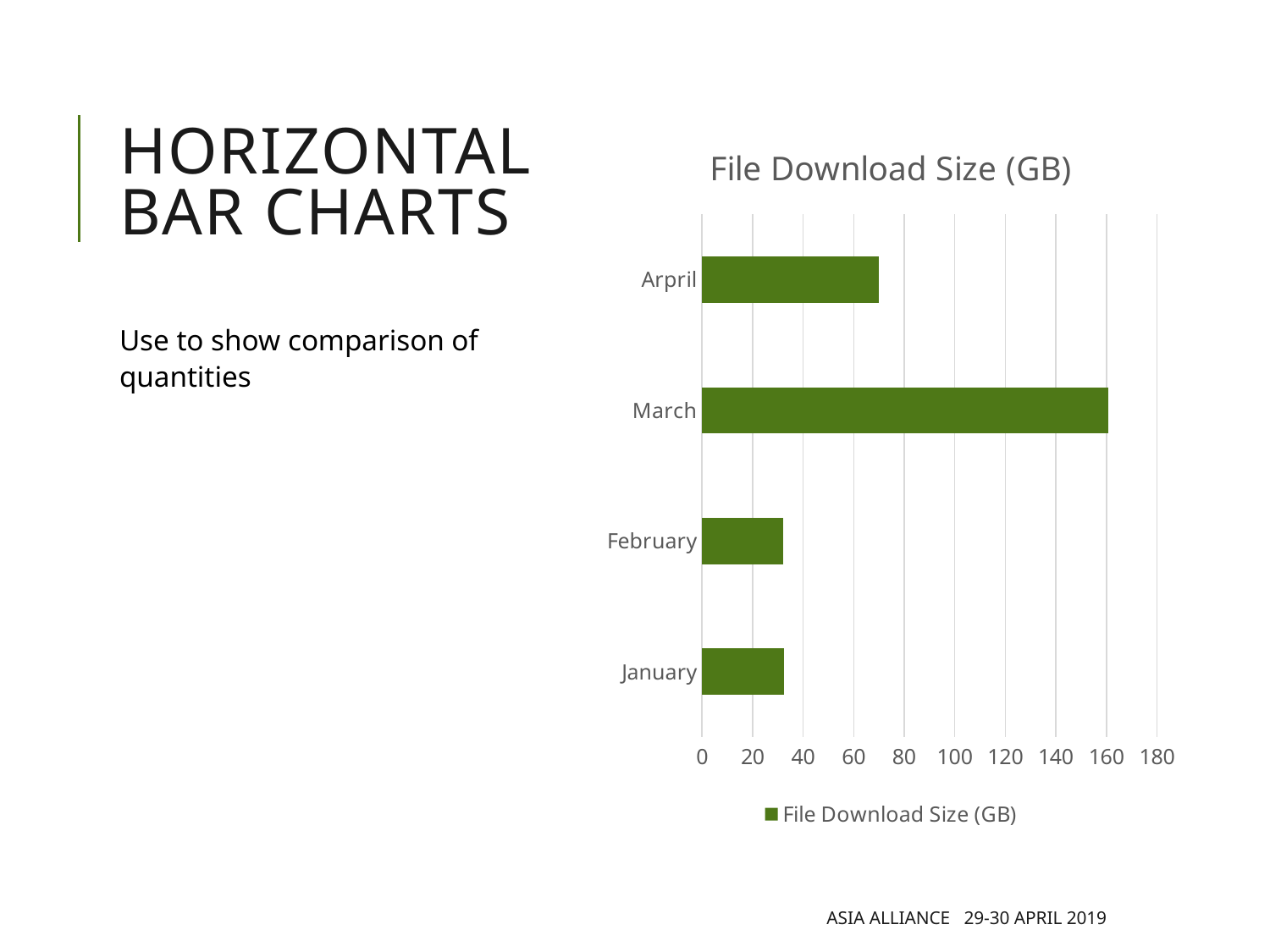
What type of chart is shown on the slide? bar chart Which is larger, the value for March or the value for Arpril? March Which is larger, the value for Arpril or the value for February? Arpril Is the value for March greater or less than 140? greater Is the value for Arpril greater or less than 80? less Is the value for Arpril greater or less than 60? greater Which month has the highest file download size? March What is the title of the chart? File Download Size (GB) How many categories (months) are shown in the chart? 4 How many series does the legend list? 1